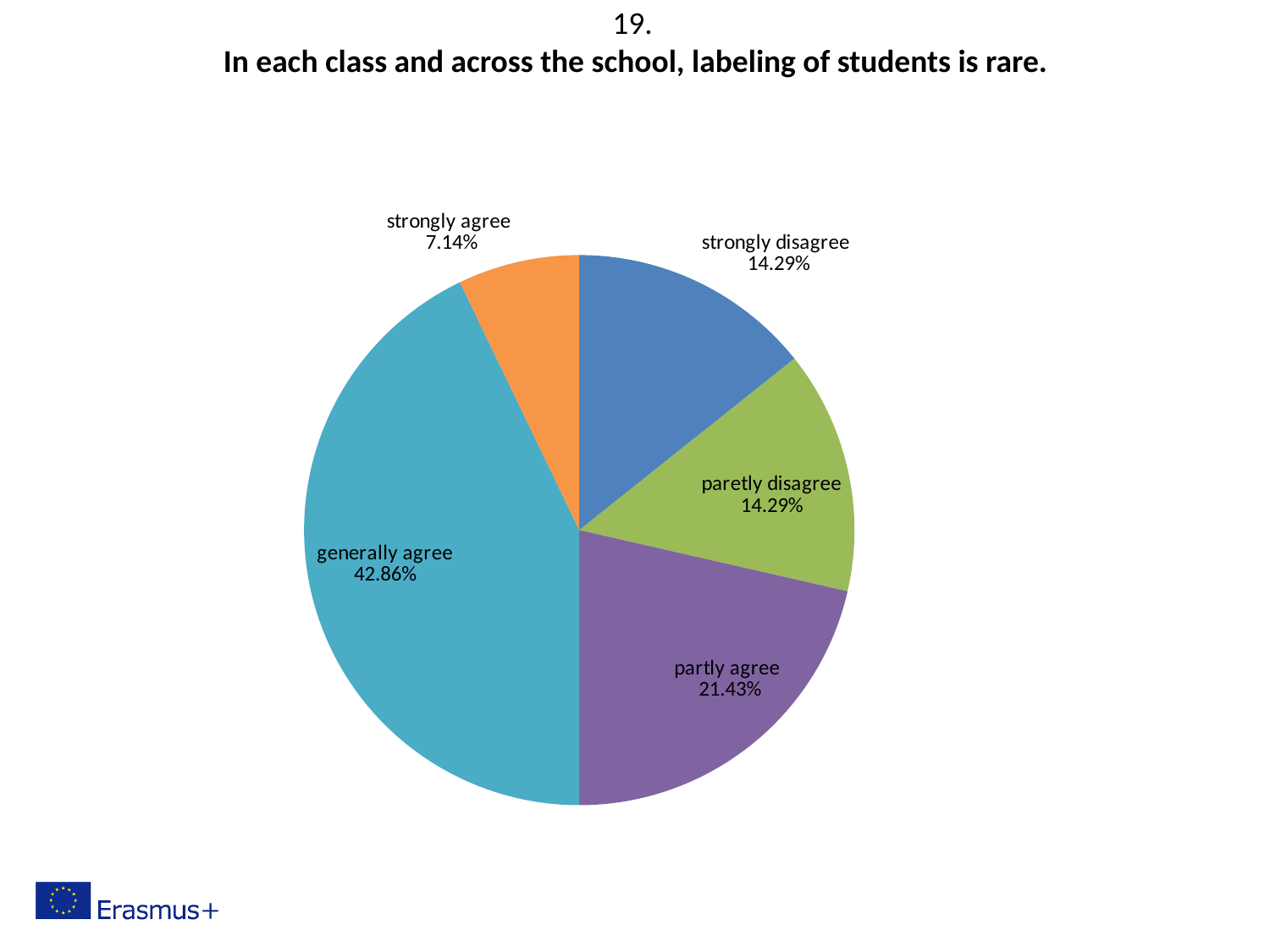
What is the difference in percentage points between "generally agree" and "partly agree"? 21.43 Which is larger, the slice for "partly agree" or the slice for "paretly disagree"? partly agree What is the value shown for "strongly disagree"? 14.29% How many slices does the pie chart have? 5 What colour is the "generally agree" slice? teal/light blue Which category has the smallest slice of the pie? strongly agree Which category has the largest slice of the pie? generally agree What is the difference in percentage points between "strongly disagree" and "strongly agree"? 7.15 What kind of chart is shown on the slide? pie chart What share of the pie is labeled "generally agree"? 42.86% What is the value shown for "strongly agree"? 7.14% What is the value shown for "partly agree"? 21.43%